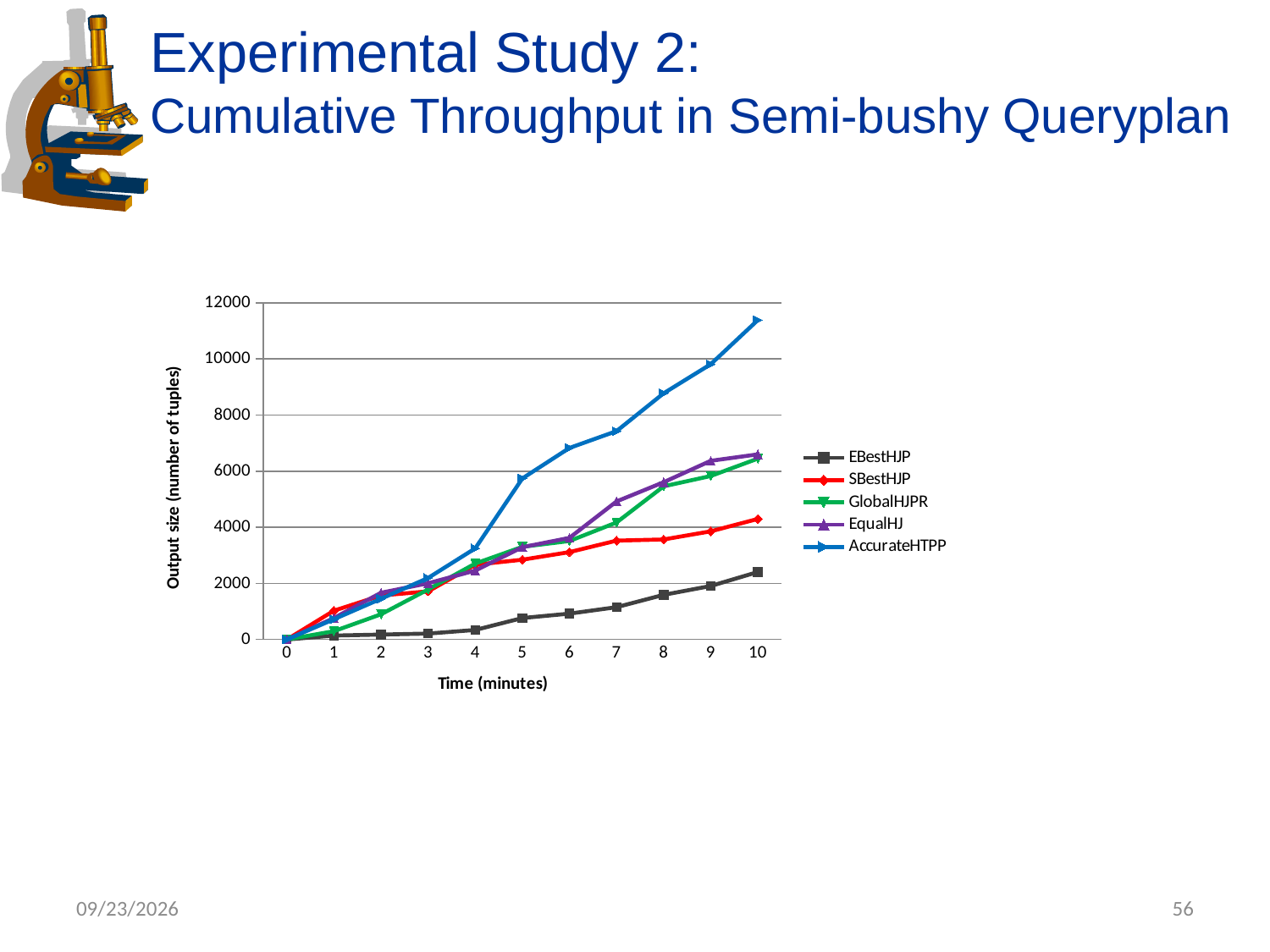
What kind of chart is shown on the slide? line chart Is the value for EBestHJP at 10 minutes greater or less than 4000? less Is the value for AccurateHTPP at 10 minutes greater or less than 10000? greater At 10 minutes, which is larger: EqualHJ or SBestHJP? EqualHJ Is the value for AccurateHTPP at 5 minutes greater or less than 4000? greater What is the y-axis label of the chart? Output size (number of tuples) Which series has the highest output size at 10 minutes? AccurateHTPP How many time points are plotted along the x axis for each series? 11 Which series has the lowest output size at 10 minutes? EBestHJP Does the AccurateHTPP series rise or fall as time increases? rise How many series does the legend list? 5